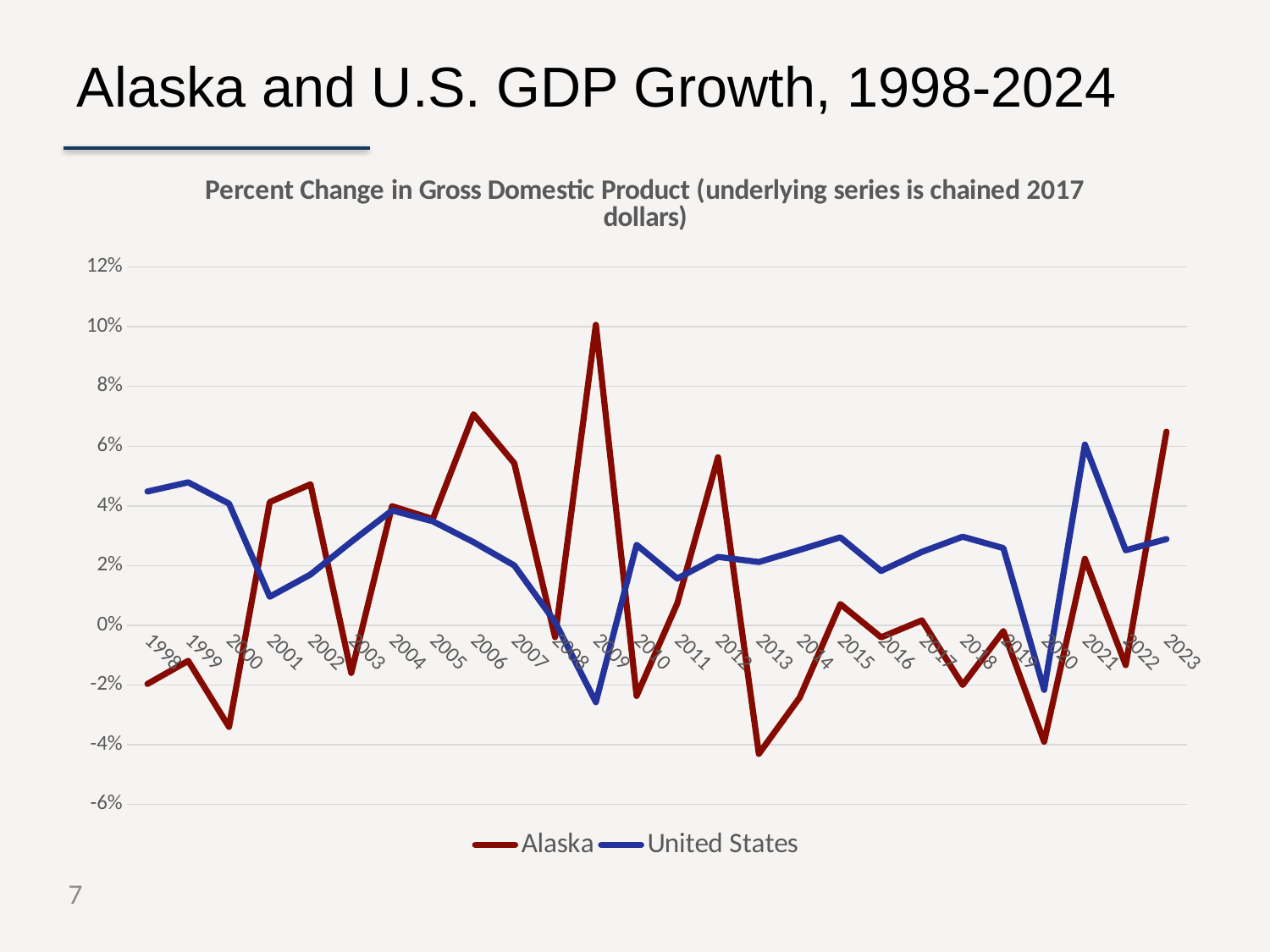
Is the value for Alaska in 2009 greater or less than 8%? greater How many years are plotted along the x axis? 26 Is the value for Alaska in 2020 greater or less than -2%? less In which year does the United States series reach its highest value? 2021 In which year does the Alaska series reach its highest value? 2009 In which year does the Alaska series reach its lowest value? 2013 Which series has the larger value in 2009, Alaska or United States? Alaska Is the value for the United States in 2021 greater or less than 4%? greater What colour is the line for the United States series? blue What kind of chart is shown on the slide? line chart Which series has the larger value in 2000, Alaska or United States? United States How many series does the legend list? 2